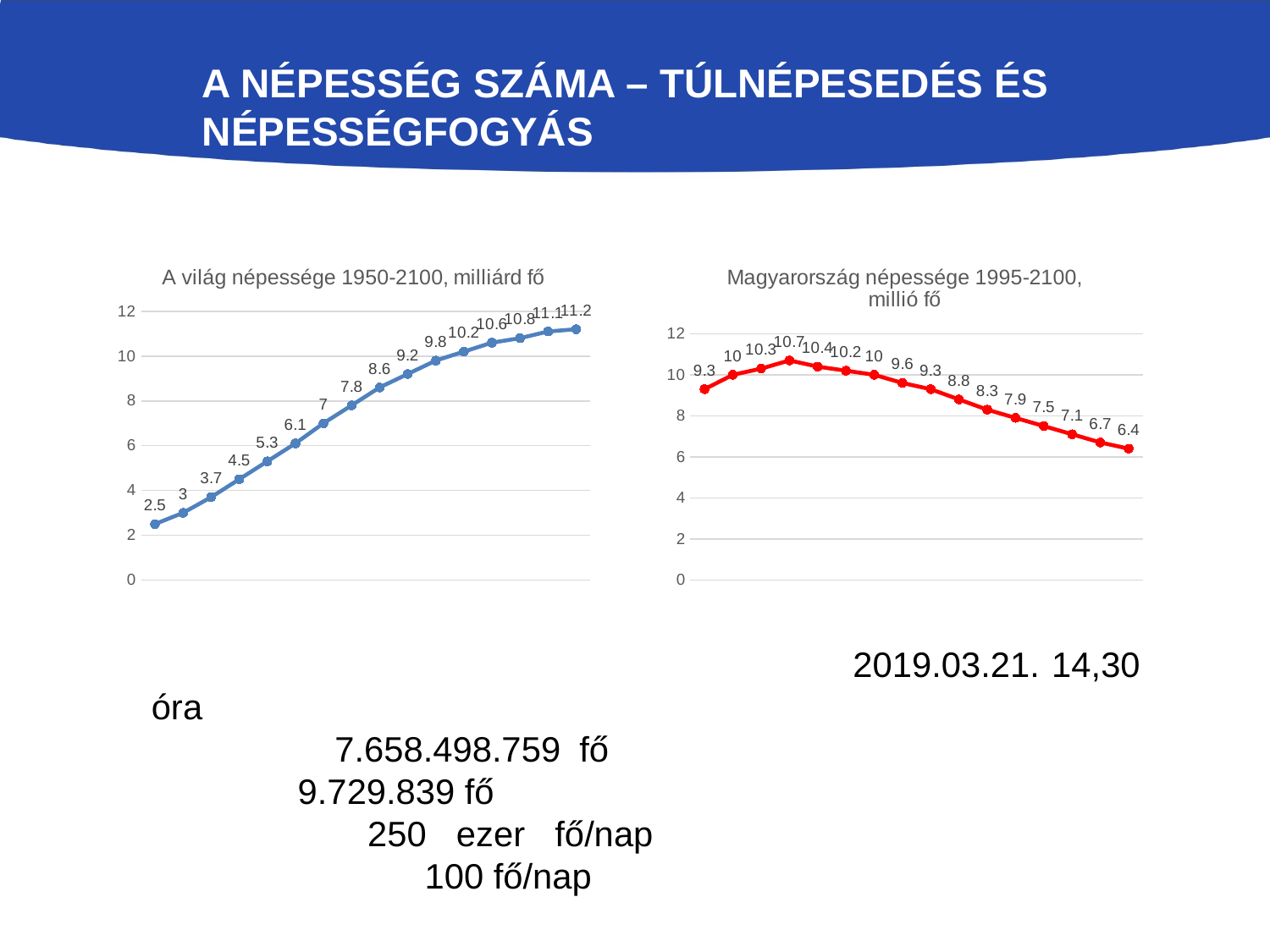
In the right chart (Magyarország népessége 1995-2100), what is the difference between the first value (9.3) and the last value (6.4)? 2.9 What type of chart is the right chart titled "Magyarország népessége 1995-2100, millió fő"? line chart In the right chart (Magyarország népessége 1995-2100), what is the highest value shown? 10.7 How many data points are plotted in the left chart (A világ népessége 1950-2100)? 16 How many data points are plotted in the right chart (Magyarország népessége 1995-2100)? 16 In the left chart (A világ népessége 1950-2100), what is the difference between the last value and the first value? 8.7 What colour is the line in the right chart (Magyarország népessége 1995-2100)? red In the left chart (A világ népessége 1950-2100), do the values rise or fall along the x axis? rise In the right chart (Magyarország népessége 1995-2100), what is the lowest value shown? 6.4 What type of chart is the left chart titled "A világ népessége 1950-2100, milliárd fő"? line chart In the left chart (A világ népessége 1950-2100), what is the value of the first data point? 2.5 In the left chart (A világ népessége 1950-2100), what is the value of the last data point? 11.2